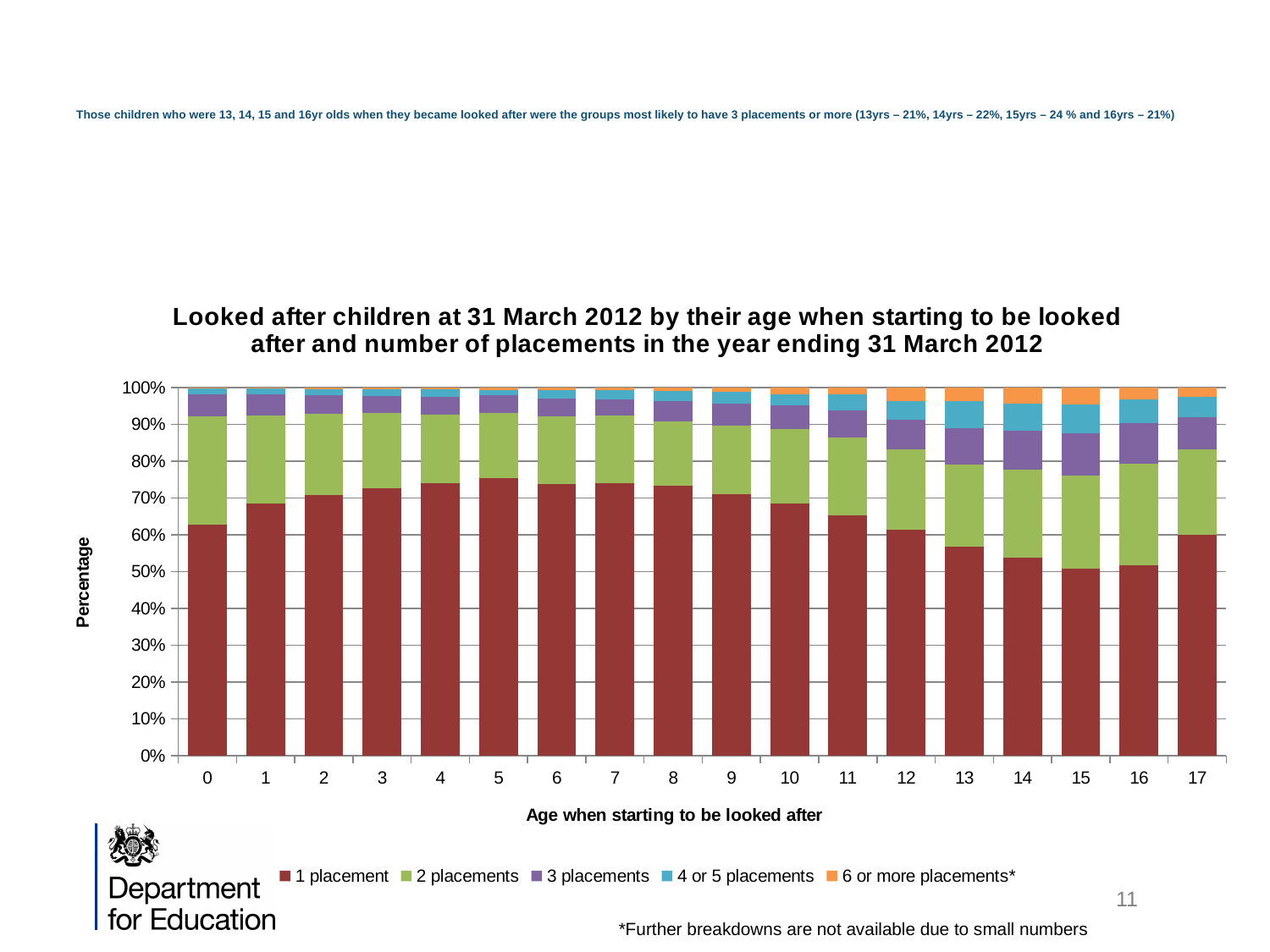
How many age categories are shown on the x axis of the chart? 18 Is the value for 1 placement at age 13 greater or less than 60%? less Which legend entry is shown in orange? 6 or more placements* How many series does the chart legend list? 5 Is the value for 1 placement at age 5 greater or less than 70%? greater Is the value for 1 placement at age 0 greater or less than 60%? greater Which is larger, the 1 placement share at age 0 or at age 5? Age 5 Does the 1 placement share rise or fall from age 7 to age 15? Fall What is the label of the x axis? Age when starting to be looked after What does each stacked bar total on the y axis? 100% Which is larger, the 1 placement share at age 3 or at age 13? Age 3 What kind of chart is shown on the slide? Stacked bar chart